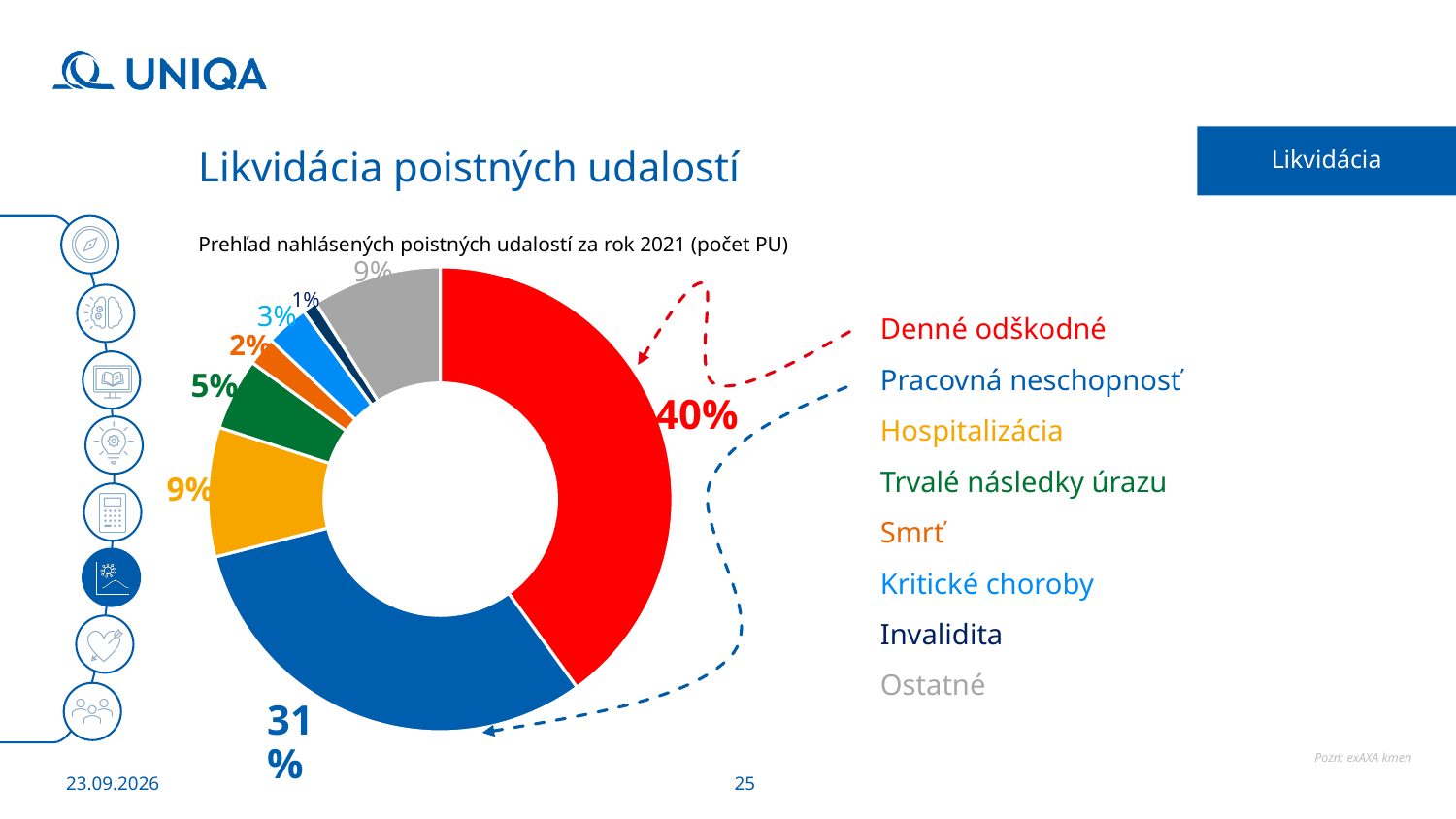
Which category has the largest share of the chart? Denné odškodné Which is larger, the share for Smrť or the share for Kritické choroby? Kritické choroby Which category has the smallest share of the chart? Invalidita What type of chart is shown on the slide? Doughnut chart What percentage is shown for Hospitalizácia? 9% What is the value shown for Pracovná neschopnosť? 31% What percentage is shown for Kritické choroby? 3% What is the value for Trvalé následky úrazu? 5% How many categories does the chart show? 8 What is the difference in percentage points between Denné odškodné and Pracovná neschopnosť? 9 What share of the chart does Denné odškodné account for? 40% What is the value for Invalidita? 1%